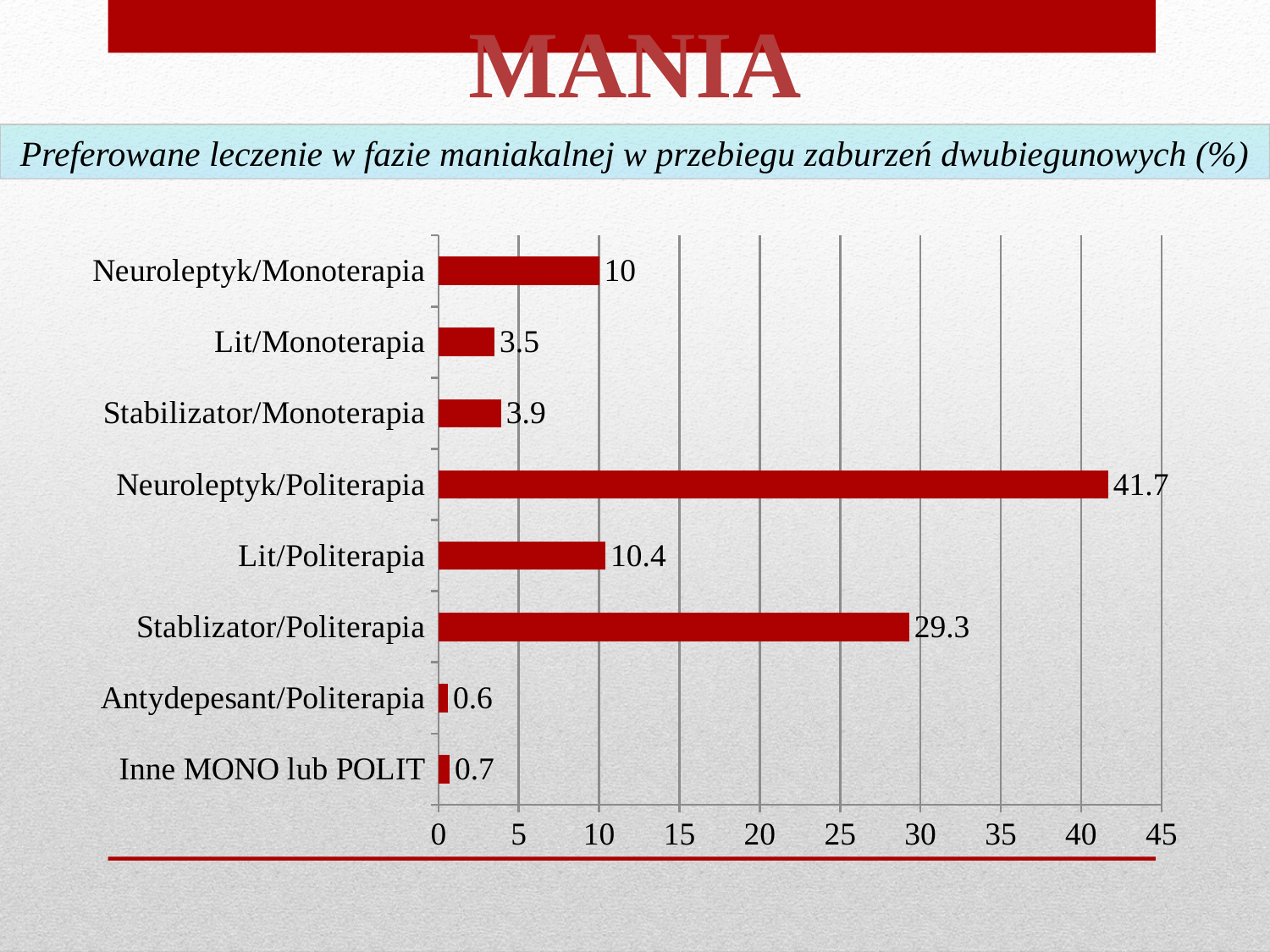
Which category has the highest value? Neuroleptyk/Politerapia How many categories are shown in the chart? 8 What is the difference between the values for Neuroleptyk/Politerapia and Stablizator/Politerapia? 12.4 Which is larger, the value for Lit/Politerapia or the value for Neuroleptyk/Monoterapia? Lit/Politerapia What is the value for Stablizator/Politerapia? 29.3 Which category has the lowest value? Antydepesant/Politerapia What is the maximum value shown on the x axis? 45 What is the value for Neuroleptyk/Politerapia? 41.7 What kind of chart is shown on the slide? bar chart What is the value for Lit/Monoterapia? 3.5 Is the value for Stablizator/Politerapia greater or less than 25? greater What is the value for Antydepesant/Politerapia? 0.6